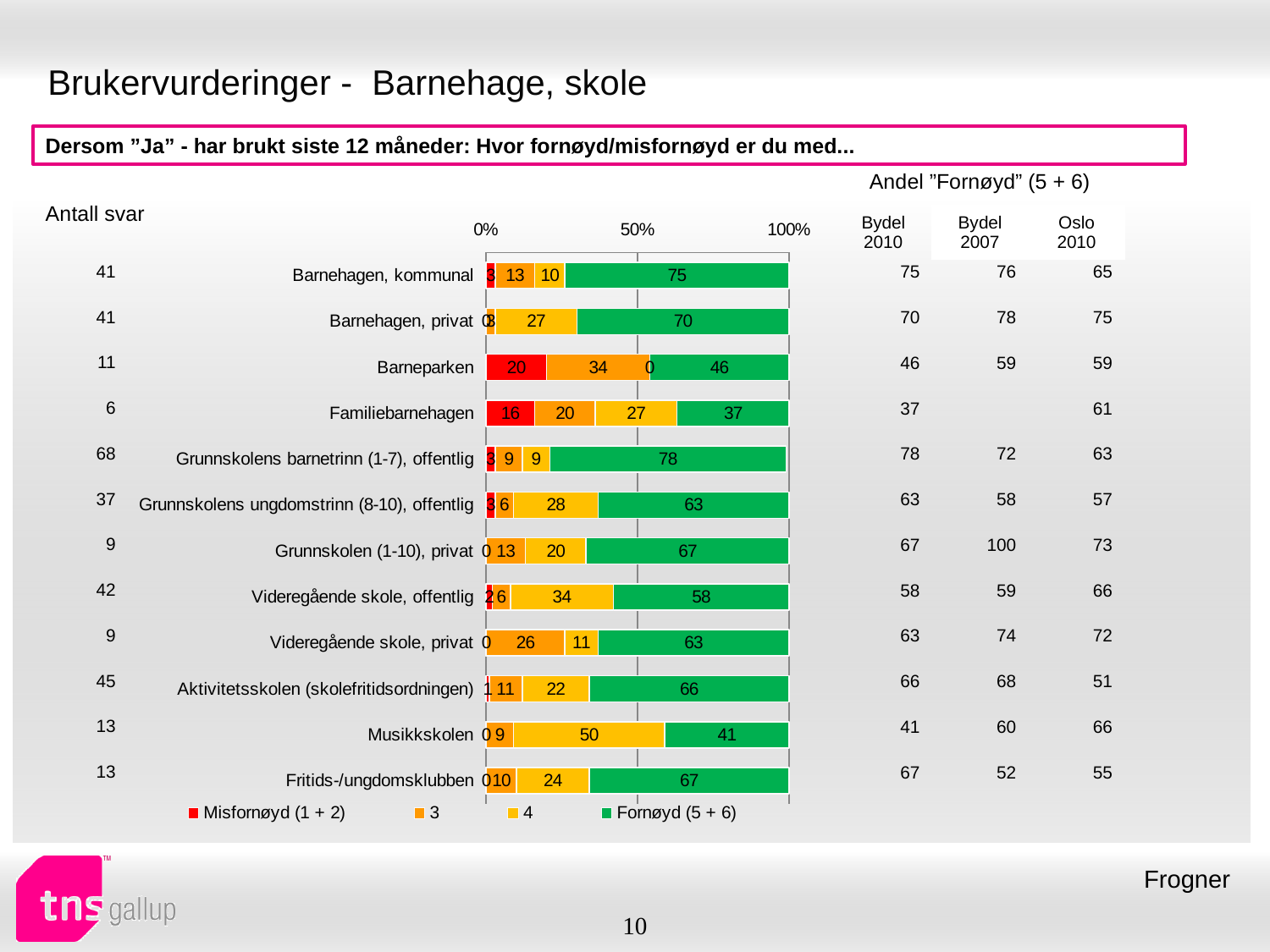
What kind of chart is shown on the slide? Stacked bar chart What is the "Fornøyd (5 + 6)" value for Musikkskolen? 41 How many series does the legend list? 4 Which has a larger "Fornøyd (5 + 6)" value: Videregående skole, offentlig or Videregående skole, privat? Videregående skole, privat What is the first entry in the chart legend? Misfornøyd (1 + 2) Which category has the highest "Fornøyd (5 + 6)" value? Grunnskolens barnetrinn (1-7), offentlig What is the "Fornøyd (5 + 6)" value for Barnehagen, kommunal? 75 How many categories are shown in the chart? 12 What is the value of the "4" segment for Musikkskolen? 50 What is the "Misfornøyd (1 + 2)" value for Barneparken? 20 What is the difference between the "Fornøyd (5 + 6)" values for Barnehagen, kommunal and Barnehagen, privat? 5 Which category has the lowest "Fornøyd (5 + 6)" value? Familiebarnehagen